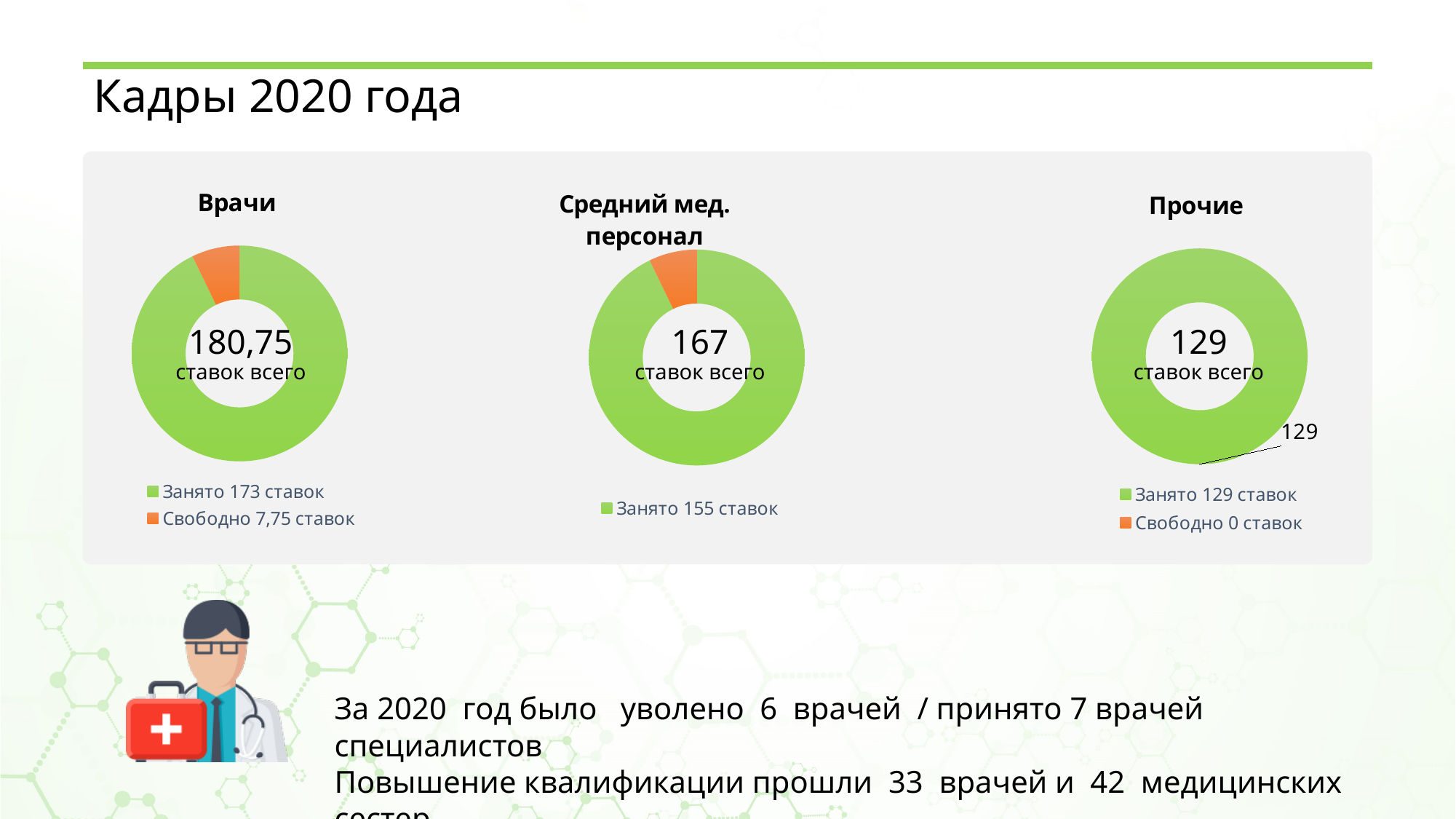
In the "Врачи" chart, what value does the legend give for "Свободно"? 7,75 ставок In the "Врачи" chart, what value does the legend give for "Занято"? 173 ставок In the "Прочие" chart, what value does the legend give for "Свободно"? 0 ставок In the "Средний мед. персонал" chart, what value does the legend give for "Занято"? 155 ставок What total number of ставок is shown in the centre of the "Врачи" chart? 180,75 How many entries does the legend of the "Врачи" chart list? 2 What total number of ставок is shown in the centre of the "Средний мед. персонал" chart? 167 How many entries does the legend of the "Средний мед. персонал" chart list? 1 In the "Прочие" chart, what value does the legend give for "Занято"? 129 ставок What kind of chart is the "Врачи" chart? doughnut chart In the "Врачи" chart, which slice is larger, "Занято" or "Свободно"? Занято In the "Врачи" chart, what colour is the "Свободно" slice? orange